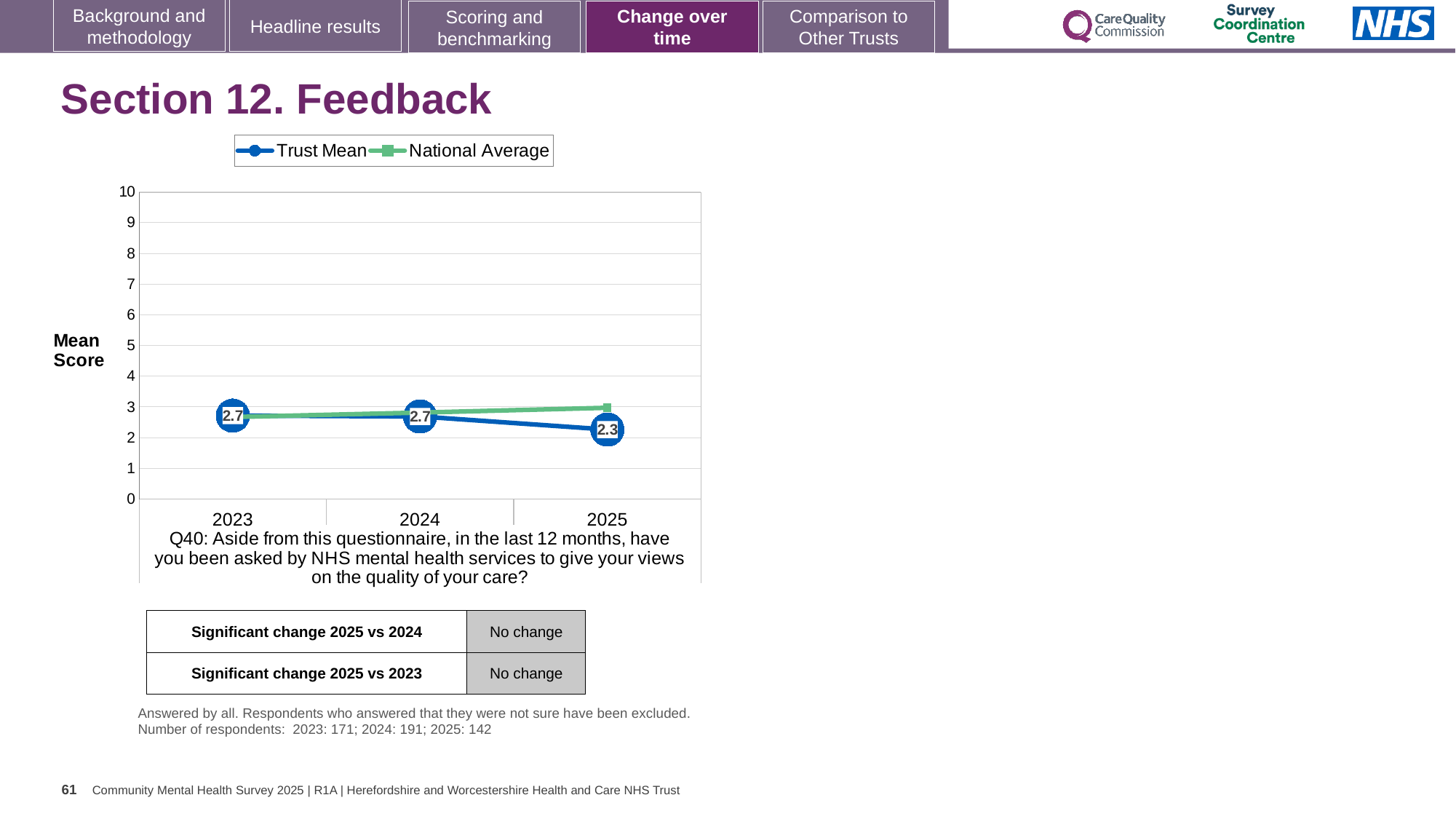
What is the Trust Mean value for 2025? 2.3 In which year is the Trust Mean lowest? 2025 Is the National Average value for 2023 greater or less than 5? less How many years are plotted on the x axis? 3 Which year has the larger Trust Mean, 2023 or 2025? 2023 What kind of chart is shown on the slide? Line chart In 2025, which series has the higher value, Trust Mean or National Average? National Average What is the Trust Mean value for 2023? 2.7 How many series does the legend list? 2 Is the National Average value for 2025 greater or less than 2? greater What is the difference between the Trust Mean in 2024 and in 2025? 0.4 Does the Trust Mean rise or fall from 2024 to 2025? Fall